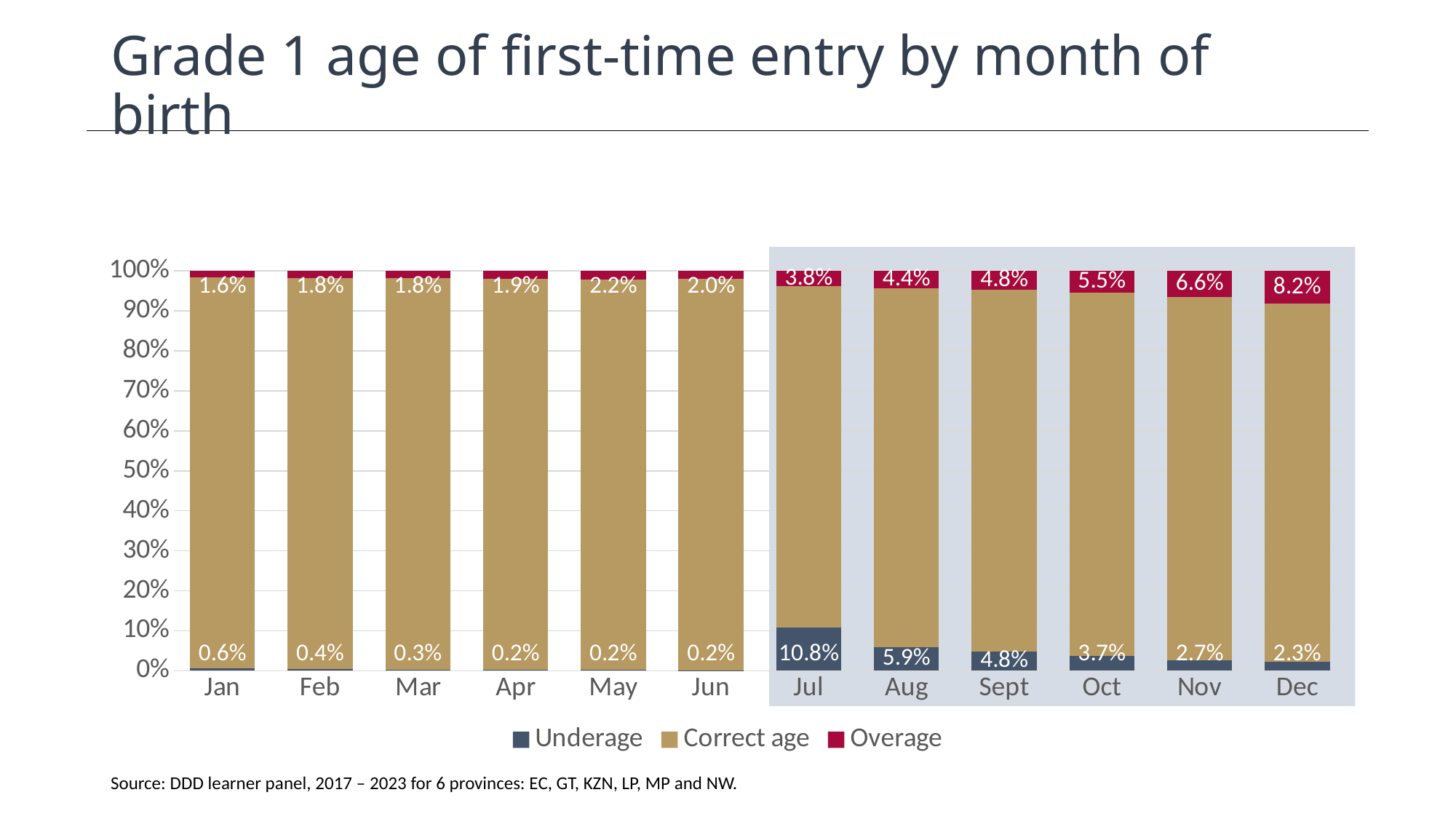
What is the Overage percentage for Mar? 1.8% Which month has the highest Overage percentage? Dec How many months are shown on the x axis? 12 Which month has the lowest Overage percentage? Jan What is the Overage percentage for Dec? 8.2% Is the Correct age share for Dec greater or less than 80%? greater How many series does the legend list? 3 Which month has the highest Underage percentage? Jul Does the Overage percentage rise or fall from Jul to Dec? rise What is the Underage percentage for Jul? 10.8% Which is larger, the Overage percentage for Nov or for Oct? Nov What is the difference between the Underage percentages for Jul and Aug? 4.9%